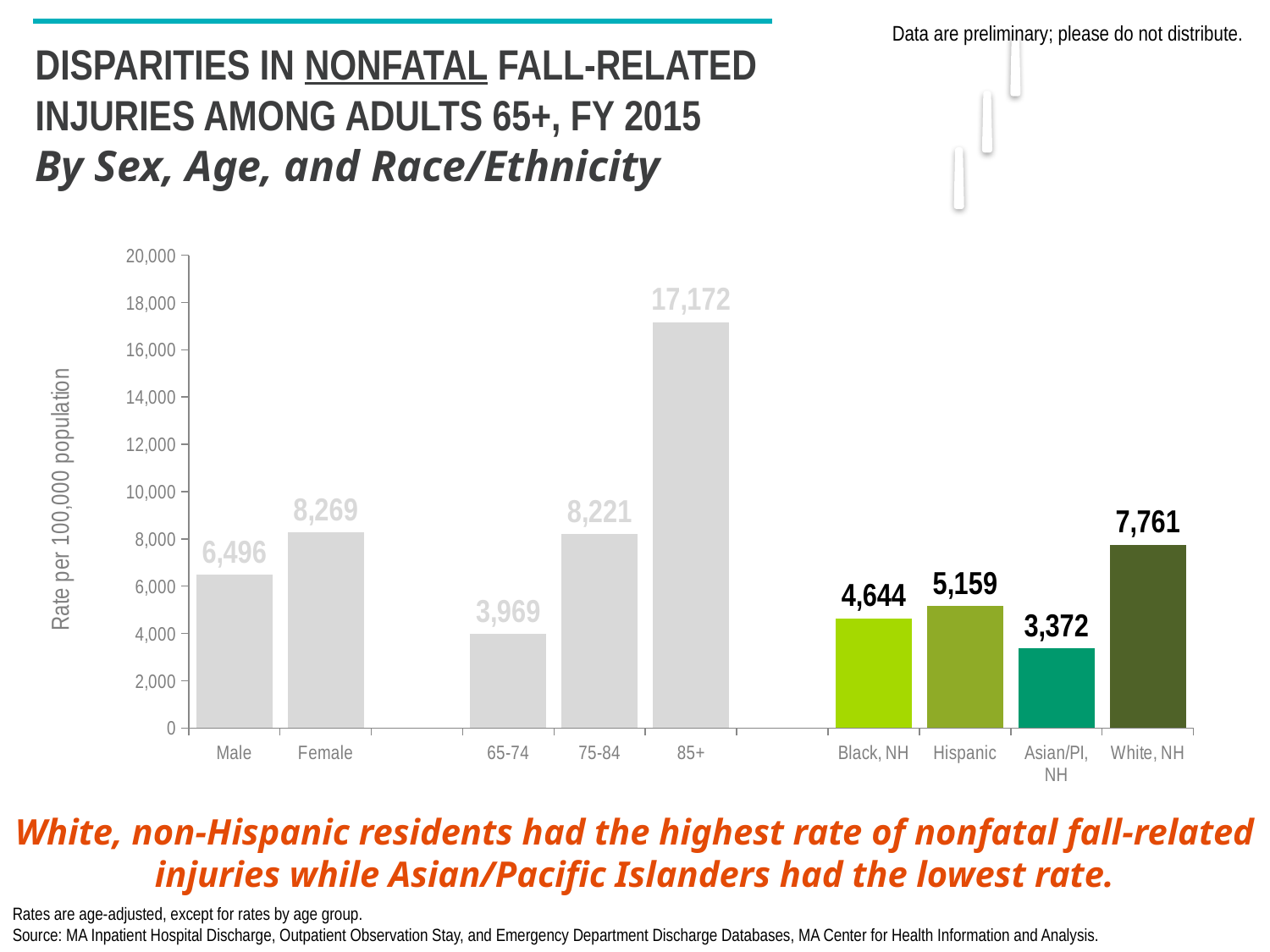
What is the rate per 100,000 population for the 85+ age group? 17,172 What is the rate per 100,000 population for Hispanic? 5,159 Which is larger, the rate for 75-84 or the rate for Female? Female Is the rate for 65-74 greater or less than 4,000? less What is the rate per 100,000 population for Female? 8,269 What kind of chart is shown on the slide? Bar chart How many bars are plotted on the chart? 9 What is the difference between the White, NH and Black, NH rates? 3,117 What is the rate per 100,000 population for Asian/PI, NH? 3,372 Which category has the highest rate on the chart? 85+ What is the difference between the Female and Male rates? 1,773 Which race/ethnicity group has the lowest rate? Asian/PI, NH